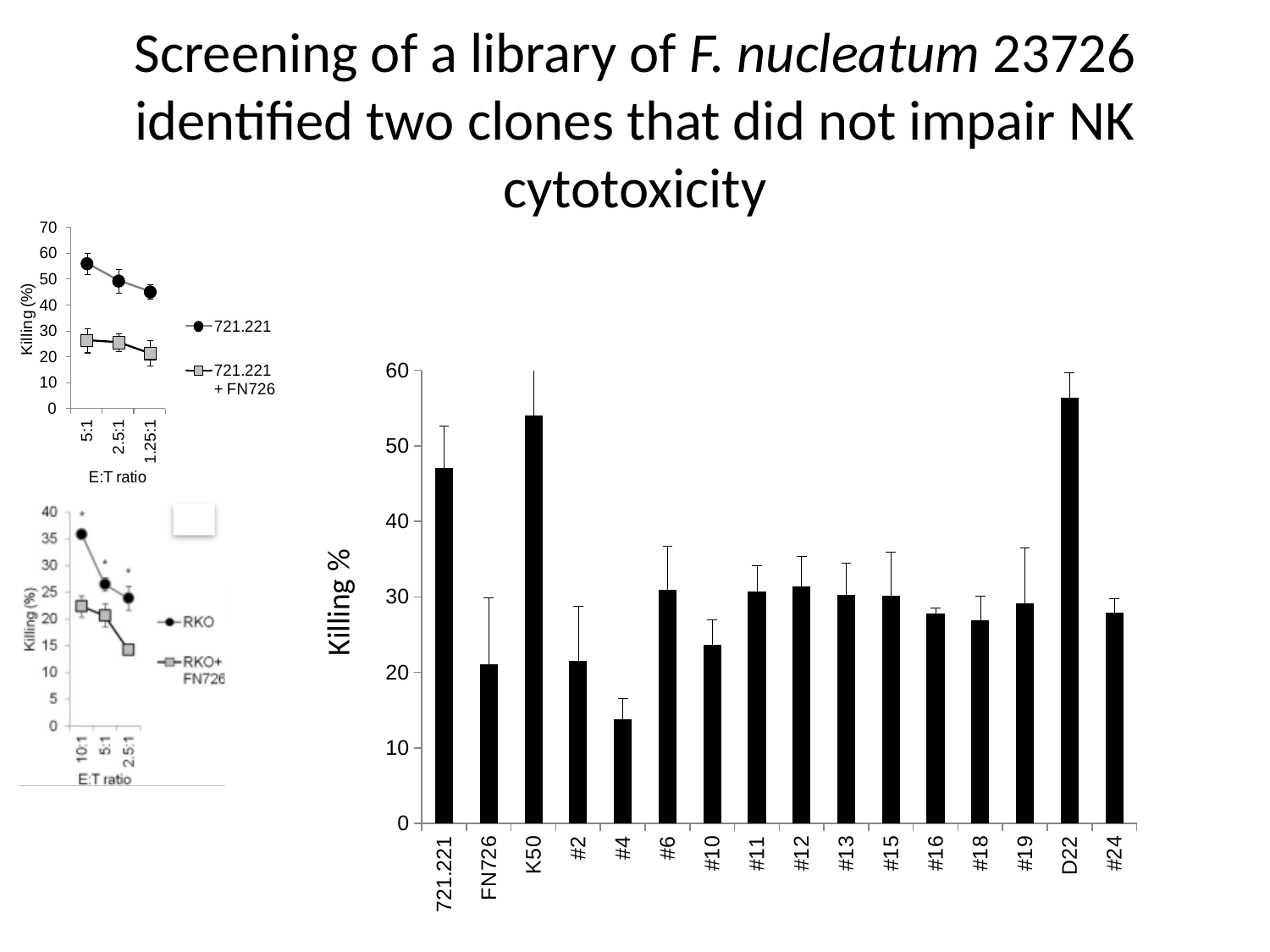
In the large bar chart on the right, which has the higher Killing %, 721.221 or FN726? 721.221 In the top-left line chart, how many series does the legend list? 2 In the bottom-left line chart, is the value for RKO at the 10:1 E:T ratio greater or less than 30? greater In the large bar chart on the right, how many categories are shown on the x axis? 16 In the large bar chart on the right, is the value for #4 greater or less than 20? less What kind of chart is the large chart on the right of the slide? bar chart In the top-left line chart, is the value for 721.221 at the 5:1 E:T ratio greater or less than 50? greater In the large bar chart on the right, which has the higher Killing %, #4 or #6? #6 In the large bar chart on the right, which category has the lowest Killing %? #4 In the top-left line chart, do the values for 721.221 rise or fall from 5:1 to 1.25:1? fall